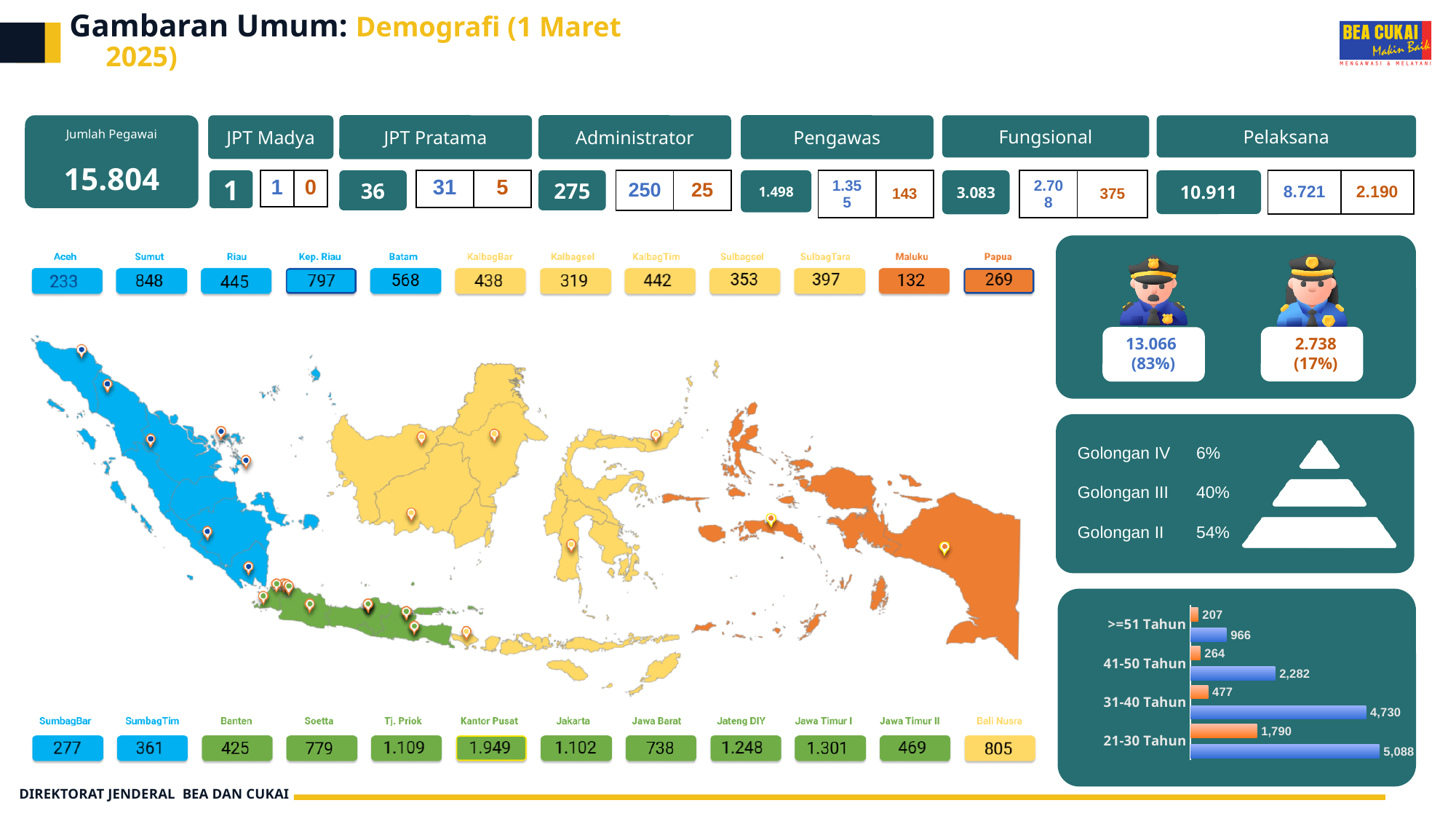
In the age-group bar chart at the bottom right, what is the value of the orange bar for >=51 Tahun? 207 In the age-group bar chart at the bottom right, which age group has the lowest orange bar? >=51 Tahun How many age groups are shown in the bar chart at the bottom right? 4 In the age-group bar chart at the bottom right, what is the value of the blue bar for 31-40 Tahun? 4,730 In the age-group bar chart at the bottom right, what is the value of the orange bar for 41-50 Tahun? 264 In the age-group bar chart at the bottom right, what is the difference between the blue bar and the orange bar for 21-30 Tahun? 3,298 In the age-group bar chart at the bottom right, what is the difference between the blue bar and the orange bar for 31-40 Tahun? 4,253 In the pyramid chart on the right, what percentage is shown for Golongan II? 54% What kind of chart is the age-group chart at the bottom right of the slide? Bar chart In the age-group bar chart at the bottom right, which has the larger blue bar: 41-50 Tahun or >=51 Tahun? 41-50 Tahun In the age-group bar chart at the bottom right, which age group has the highest blue bar? 21-30 Tahun In the age-group bar chart at the bottom right, what is the value of the blue bar for 21-30 Tahun? 5,088